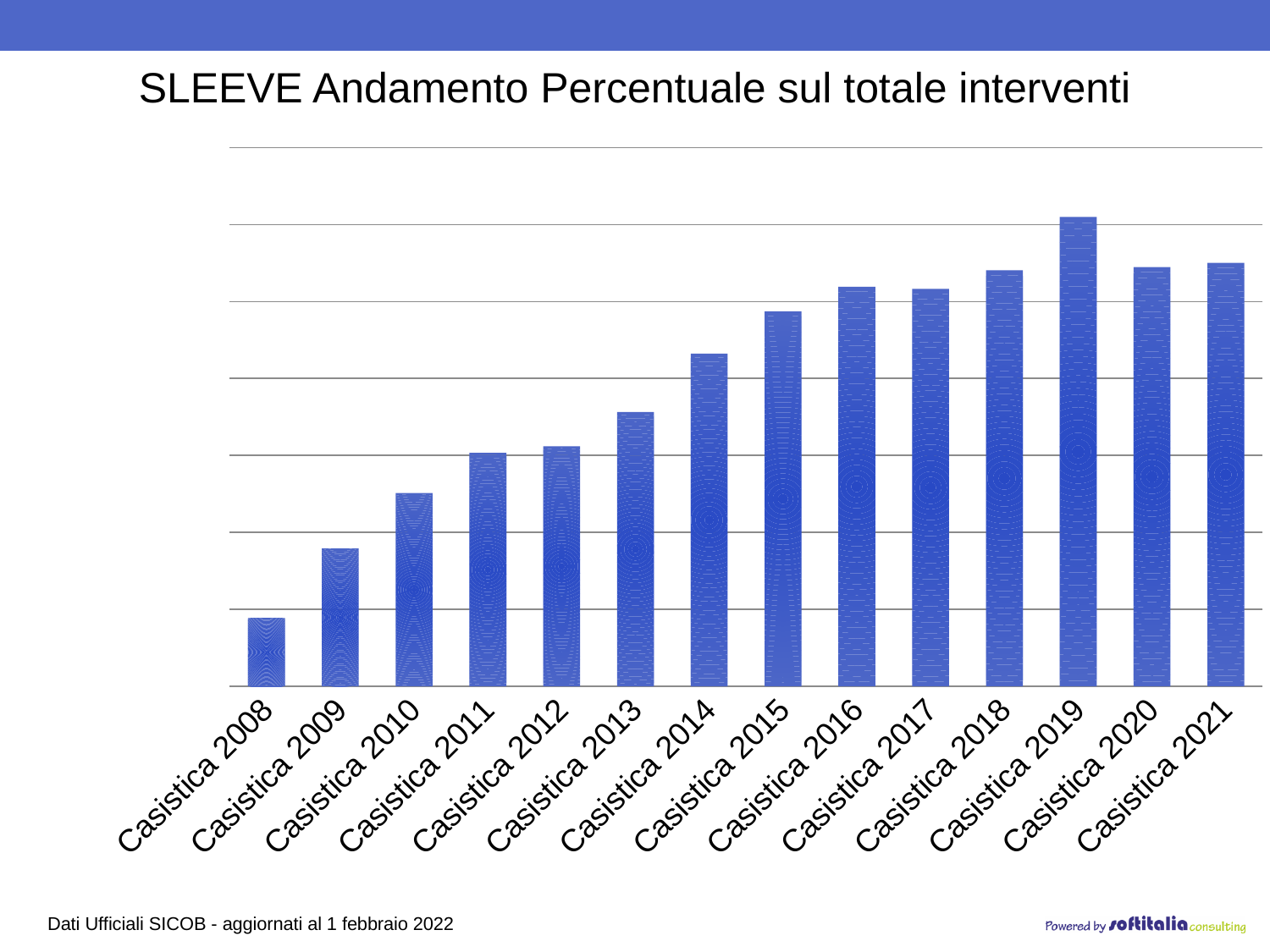
Which is larger, the value for Casistica 2008 or Casistica 2009? Casistica 2009 Which category has the lowest bar? Casistica 2008 Do the values rise or fall from Casistica 2008 to Casistica 2014? Rise Which is larger, the value for Casistica 2010 or Casistica 2013? Casistica 2013 Which is larger, the value for Casistica 2013 or Casistica 2014? Casistica 2014 Which category has the highest bar? Casistica 2019 What colour are the bars in the chart? Blue What kind of chart is shown on the slide? Bar chart How many bars (categories) are plotted in the chart? 14 What is the title of the chart? SLEEVE Andamento Percentuale sul totale interventi